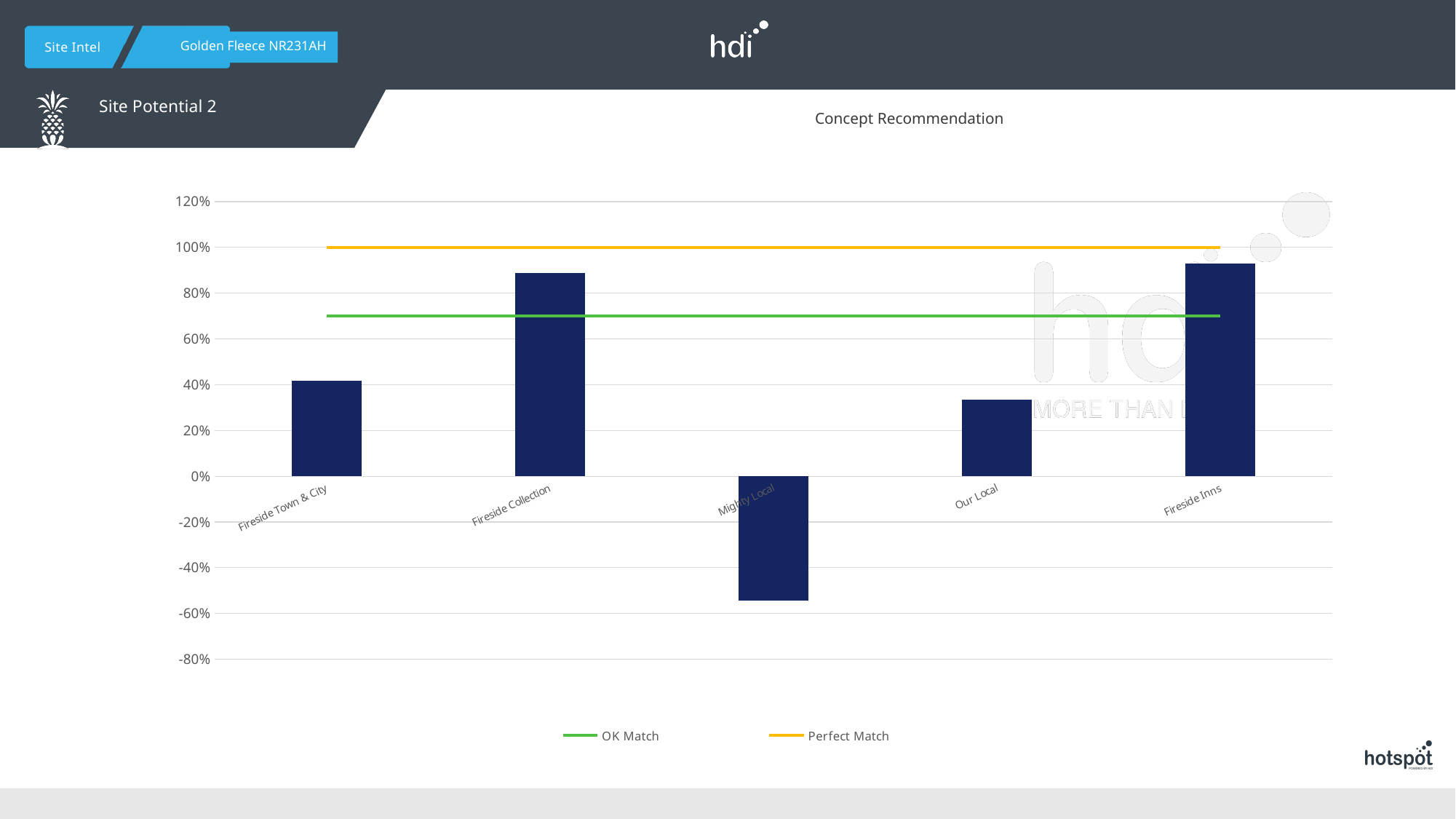
Is the value for Mighty Local greater or less than -40%? less Is the value for Fireside Town & City greater or less than 60%? less How many concept categories are plotted on the x axis? 5 Which concept has the lowest bar? Mighty Local How many entries does the legend list? 2 What kind of chart is shown on the slide? Bar chart Is the value for Fireside Collection greater or less than 80%? greater At what level on the y axis is the Perfect Match line drawn? 100% What colour is the OK Match line in the legend? Green Which concept has the highest bar? Fireside Inns Which is larger, the value for Fireside Town & City or the value for Our Local? Fireside Town & City